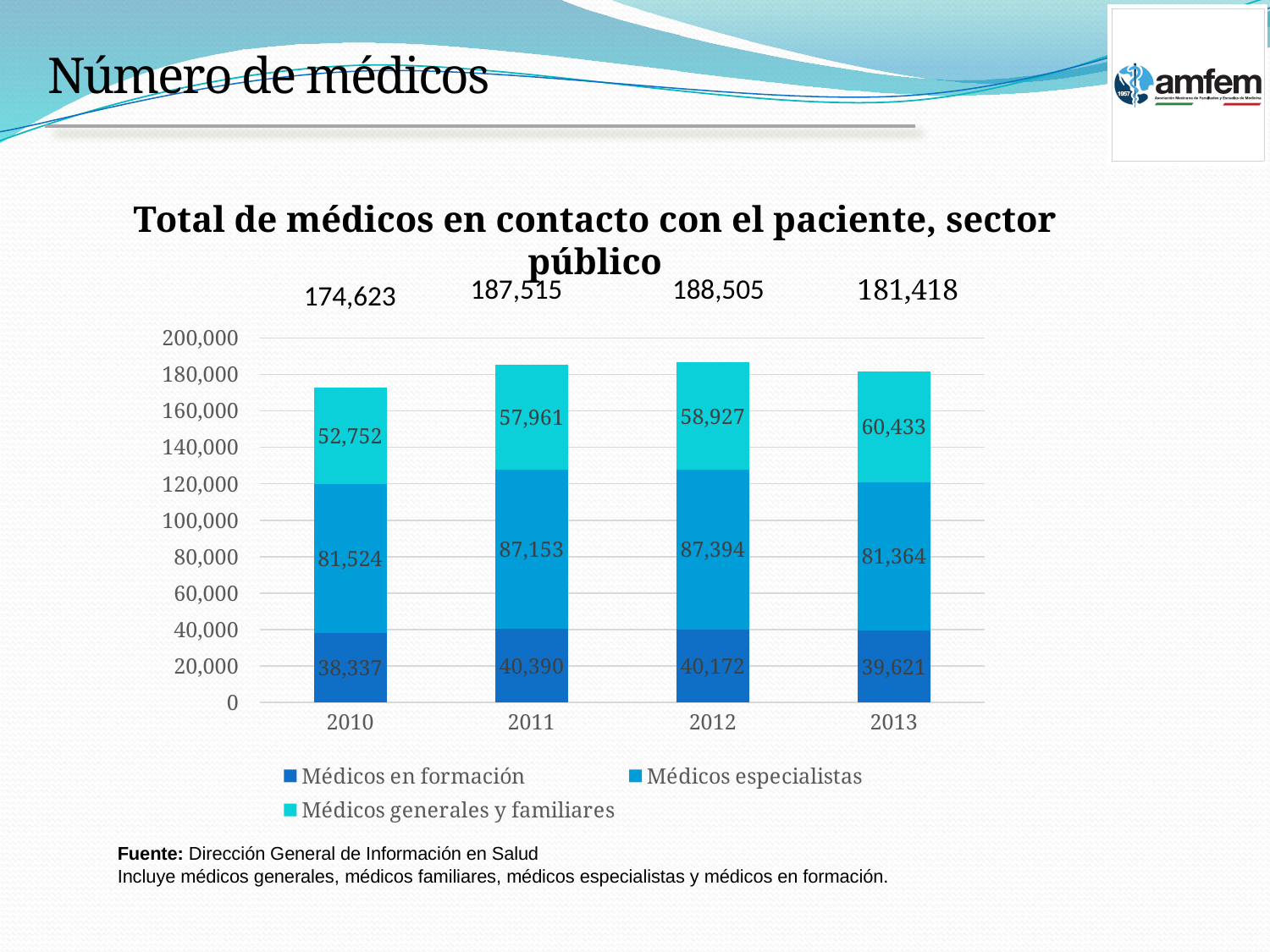
How many series does the legend list? 3 What is the title of the chart? Total de médicos en contacto con el paciente, sector público What is the value for Médicos en formación in 2010? 38,337 Which year has the highest value for Médicos generales y familiares? 2013 What is the difference between Médicos especialistas in 2011 and in 2010? 5,629 What type of chart is shown on the slide? Stacked bar chart What total is printed above the 2013 bar? 181,418 How many years are shown on the x axis? 4 Which year has the lowest value for Médicos en formación? 2010 What is the value for Médicos generales y familiares in 2013? 60,433 What is the value for Médicos especialistas in 2012? 87,394 Which is larger: Médicos en formación in 2011 or in 2012? 2011